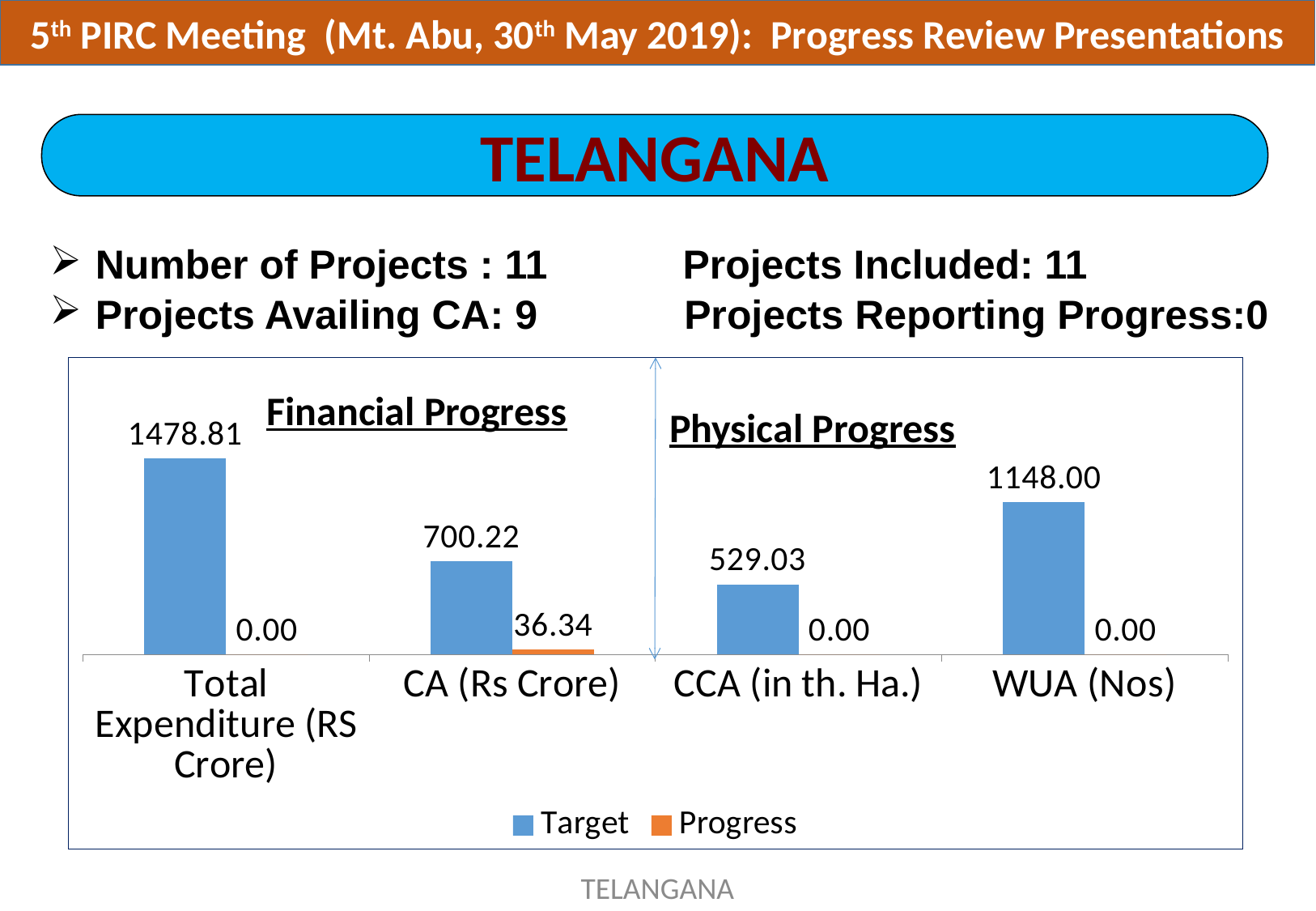
What is the Progress value for CA (Rs Crore)? 36.34 Which category has the lowest Target value? CCA (in th. Ha.) What is the Target value for Total Expenditure (RS Crore)? 1478.81 How many series does the chart legend list? 2 What is the Progress value for WUA (Nos)? 0.00 What is the difference between the Target and Progress values for CA (Rs Crore)? 663.88 What is the Target value for CCA (in th. Ha.)? 529.03 Which is larger, the Target value for WUA (Nos) or the Target value for CA (Rs Crore)? WUA (Nos) What is the Target value for WUA (Nos)? 1148.00 How many categories are shown on the x axis of the chart? 4 What kind of chart is shown on the slide? Bar chart Which category has the highest Target value? Total Expenditure (RS Crore)